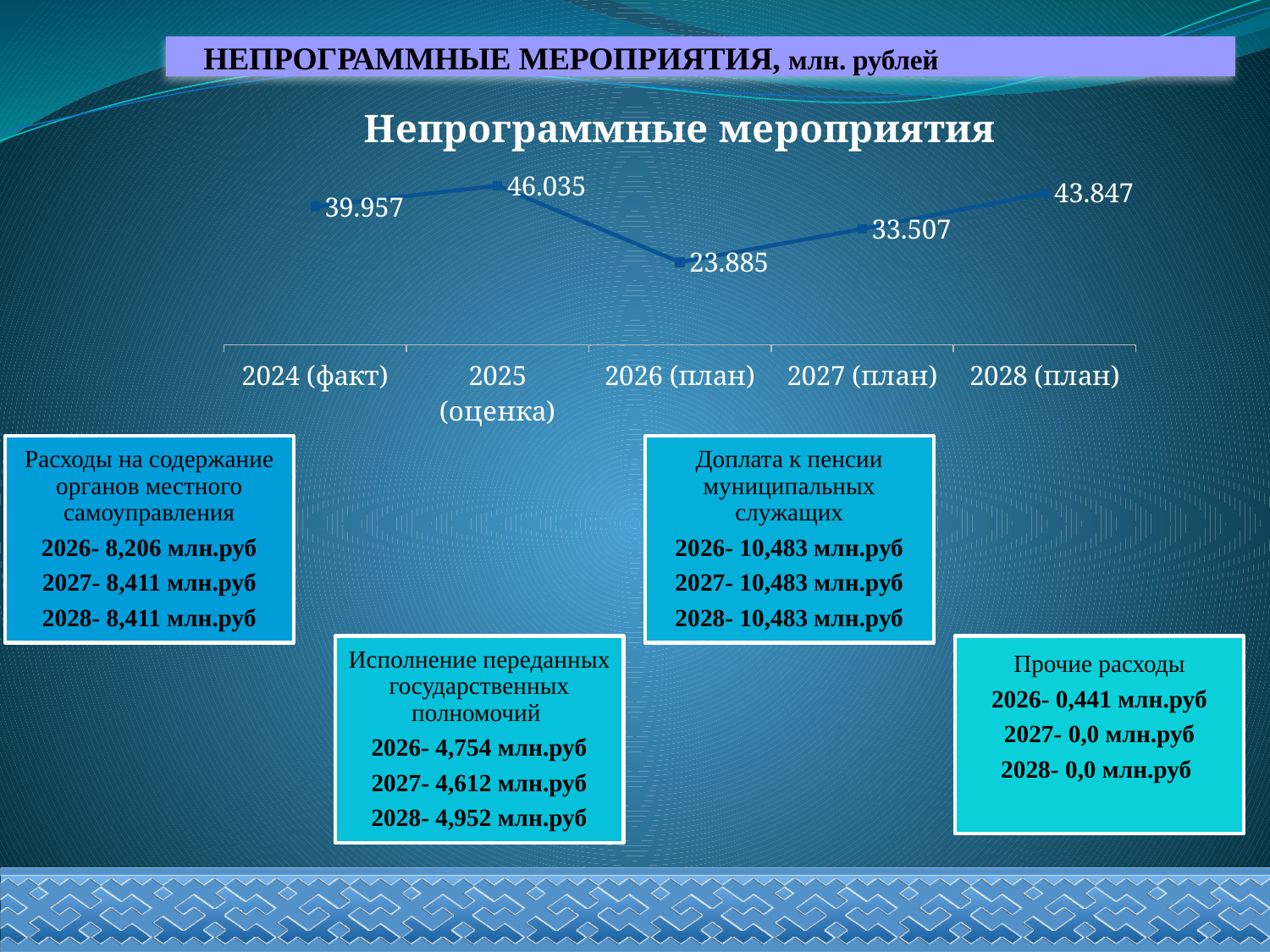
What is the value for 2026 (план) in the chart? 23.885 What is the value for 2024 (факт) in the chart? 39.957 What is the difference between the values for 2025 (оценка) and 2024 (факт)? 6.078 What is the difference between the values for 2028 (план) and 2027 (план)? 10.340 Which category has the lowest value in the chart? 2026 (план) What is the title of the chart? Непрограммные мероприятия What is the value for 2028 (план) in the chart? 43.847 Which category has the highest value in the chart? 2025 (оценка) Which is larger: the value for 2027 (план) or the value for 2026 (план)? 2027 (план) What type of chart is shown on the slide? line chart How many data points are plotted in the chart? 5 What is the value for 2027 (план) in the chart? 33.507